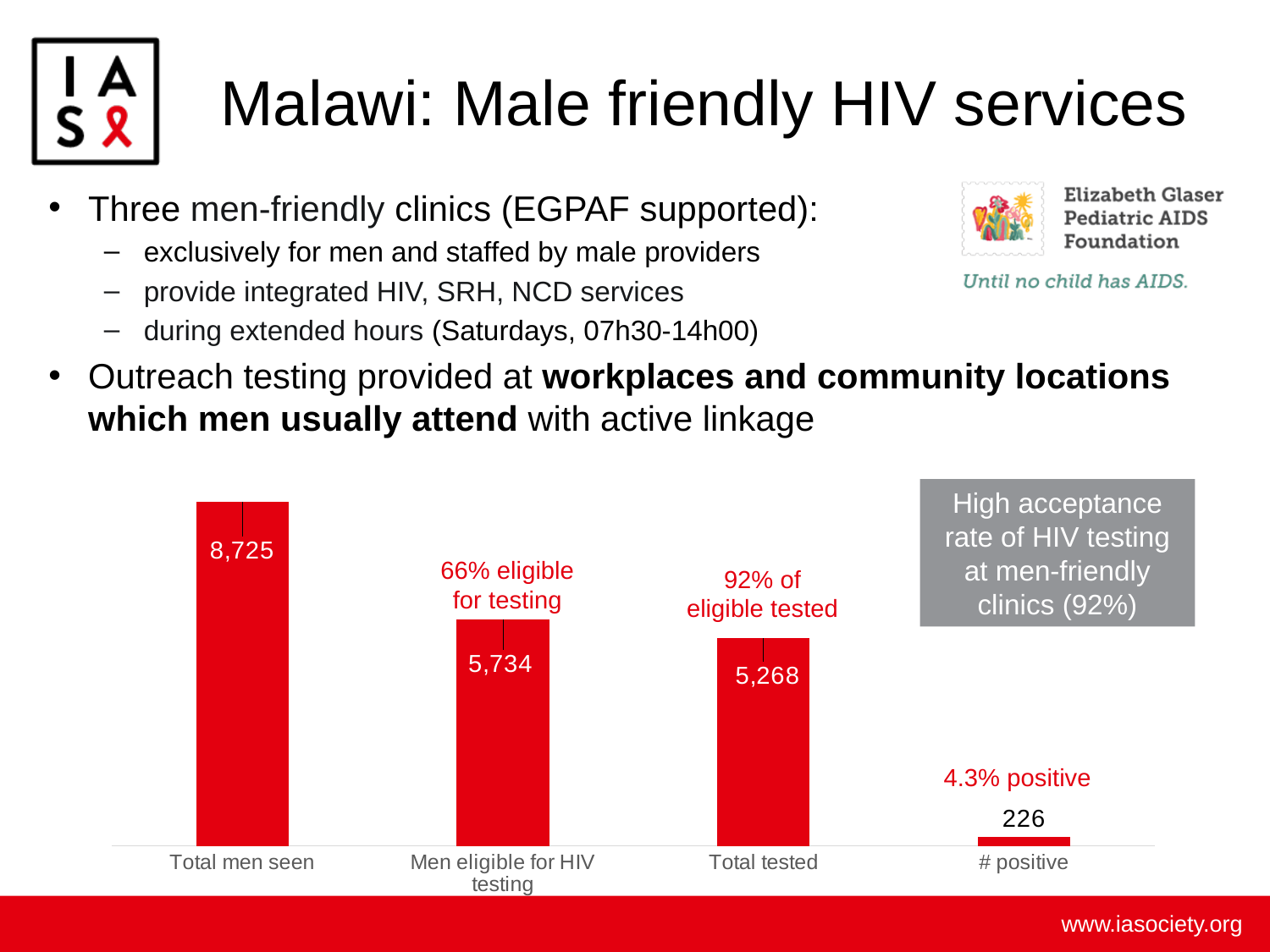
What is the value for Total tested? 5,268 Do the values rise or fall from left to right along the x axis? Fall What is the difference between Total men seen and Men eligible for HIV testing? 2,991 Which is larger, Total tested or # positive? Total tested What is the value for # positive? 226 Which category has the highest value? Total men seen Which category has the lowest value? # positive What is the value for Total men seen? 8,725 What is the difference between Men eligible for HIV testing and Total tested? 466 What is the value for Men eligible for HIV testing? 5,734 How many categories are shown on the x axis? 4 What kind of chart is shown on the slide? Bar chart